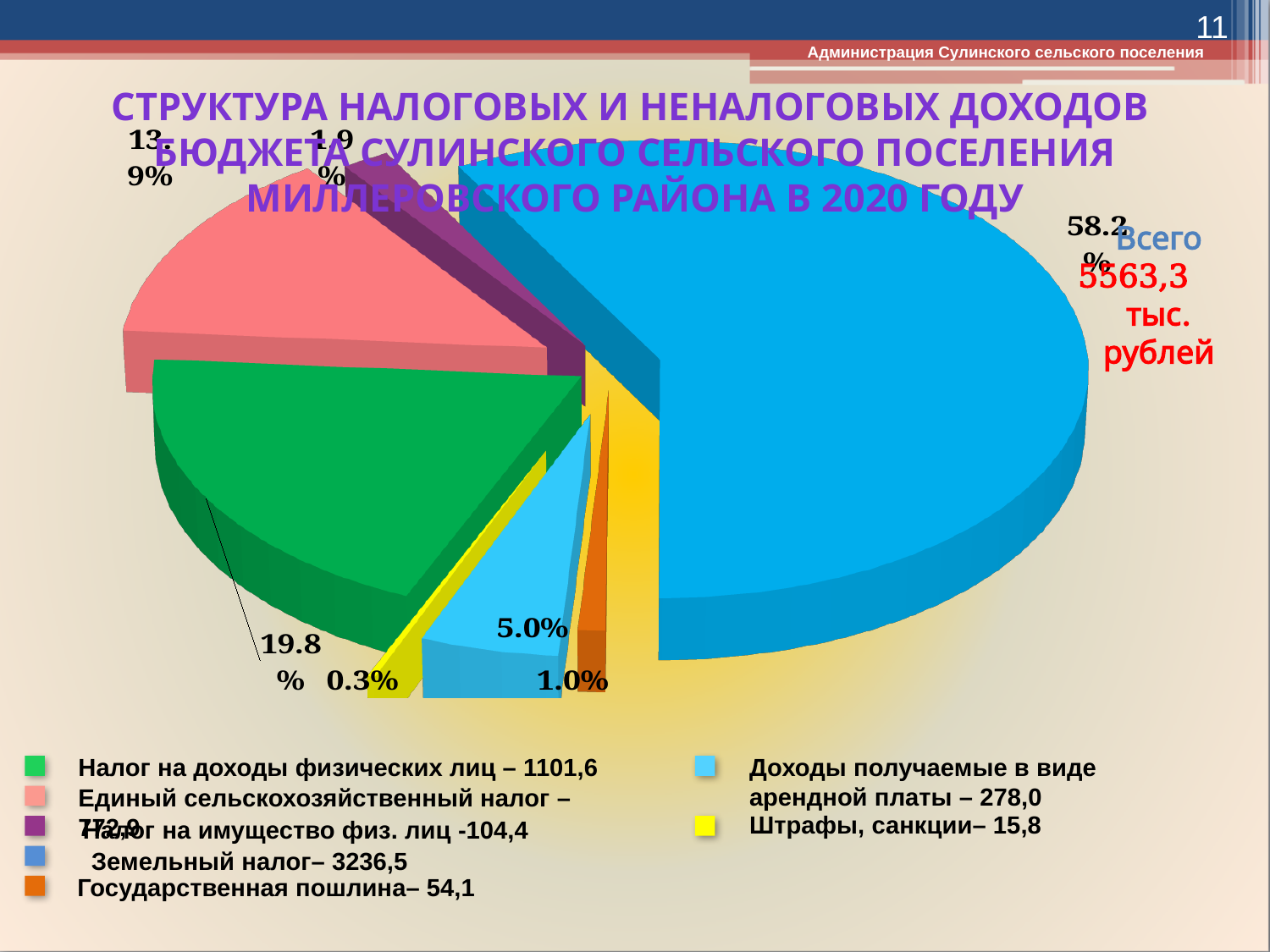
How many slices does the pie chart have? 7 What is the total of all revenues shown on the slide (Всего)? 5563,3 тыс. рублей Which is larger: the share for Налог на доходы физических лиц or the share for Единый сельскохозяйственный налог? Налог на доходы физических лиц What share of the pie does Земельный налог account for? 58.2% What is the difference in percentage points between the share for Земельный налог and the share for Налог на доходы физических лиц? 38.4 What is the value for Земельный налог shown in the legend? 3236,5 Which category has the largest share of the pie? Земельный налог What kind of chart is shown on the slide? pie chart What share of the pie does Налог на доходы физических лиц account for? 19.8% Which category has the smallest share of the pie? Штрафы, санкции What share of the pie does Доходы получаемые в виде арендной платы account for? 5.0% What is the value for Государственная пошлина shown in the legend? 54,1